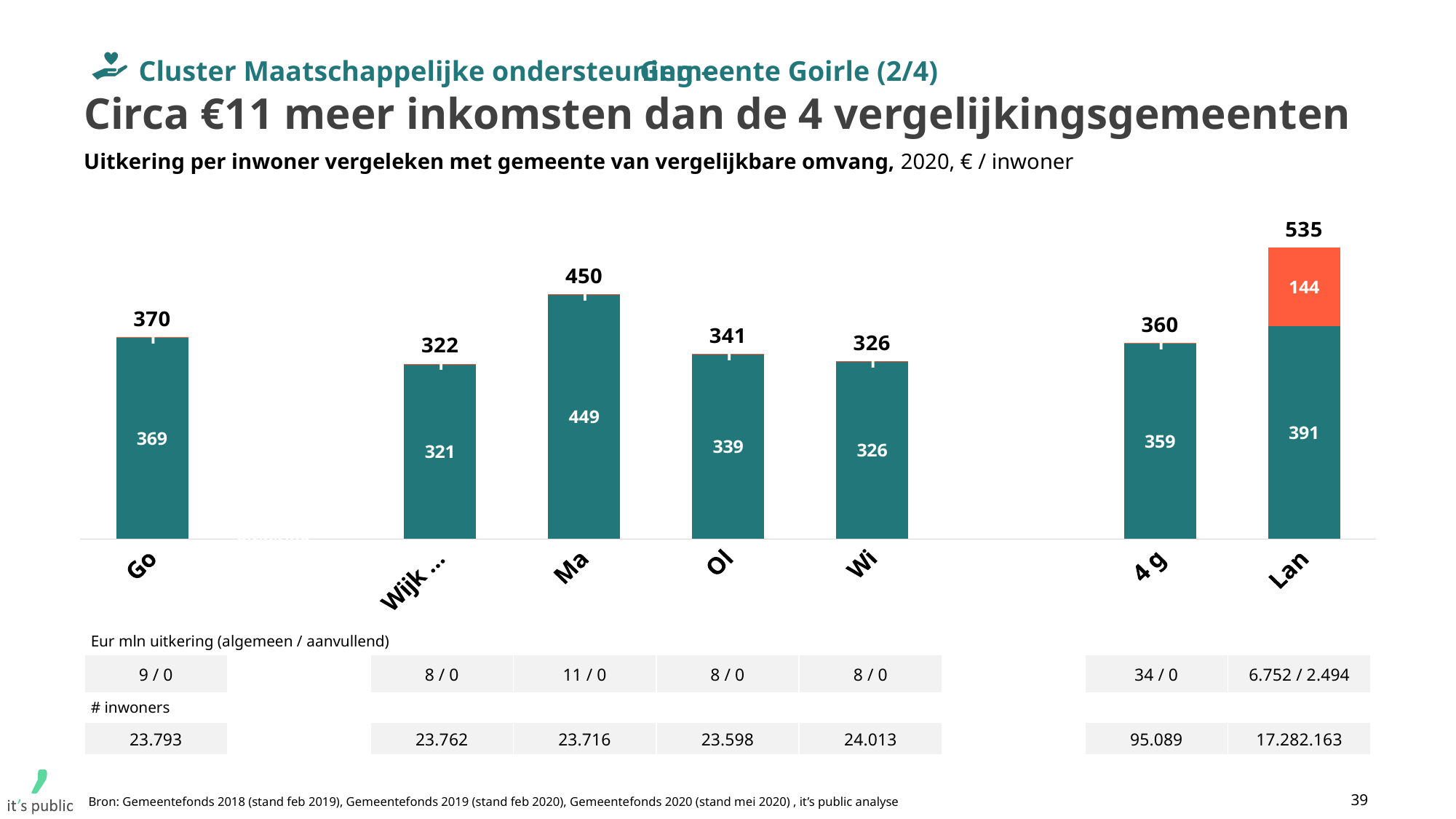
Which has a larger total value, "Ma" or "Ol"? Ma What is the total value shown above the bar for "Lan"? 535 What kind of chart is shown on the slide? Stacked bar chart What is the value of the teal segment of the bar for "Ma"? 449 Which category has the lowest total value? Wijk ... What is the sum of the two segments of the "Lan" bar (391 and 144)? 535 What is the total value shown above the bar for "Go"? 370 What is the number of inhabitants (# inwoners) listed under the "Go" bar? 23.793 Which category has the highest total value? Lan How many bars are plotted in the chart? 7 What is the difference between the total for "Go" (370) and the total for "4 g" (360)? 10 What is the value of the orange segment of the bar for "Lan"? 144